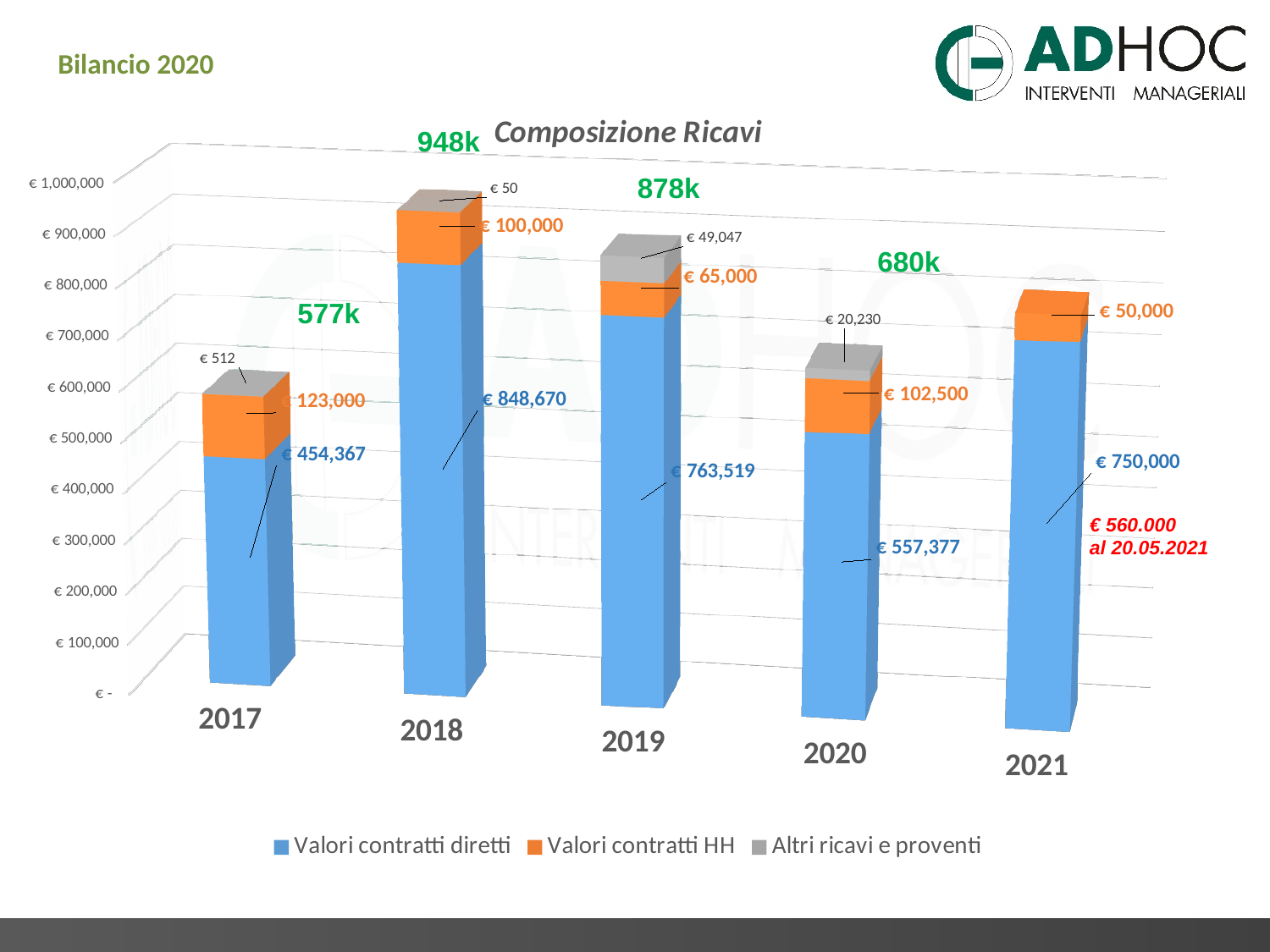
How many series does the legend list? 3 What is the difference between Valori contratti diretti in 2019 and in 2020? € 206,142 How many years are shown on the x axis? 5 What is the value of Valori contratti HH for 2020? € 102,500 Which is larger, Valori contratti HH in 2017 or in 2018? 2017 What is the value of Valori contratti diretti for 2018? € 848,670 What is the value of Altri ricavi e proventi for 2019? € 49,047 What kind of chart is shown on the slide? Stacked bar chart Which year has the lowest value for Valori contratti HH? 2021 What is the value of Altri ricavi e proventi for 2017? € 512 Which year has the highest value for Valori contratti diretti? 2018 What is the total of the stacked bar for 2018, summing the three labelled segments? € 948,720